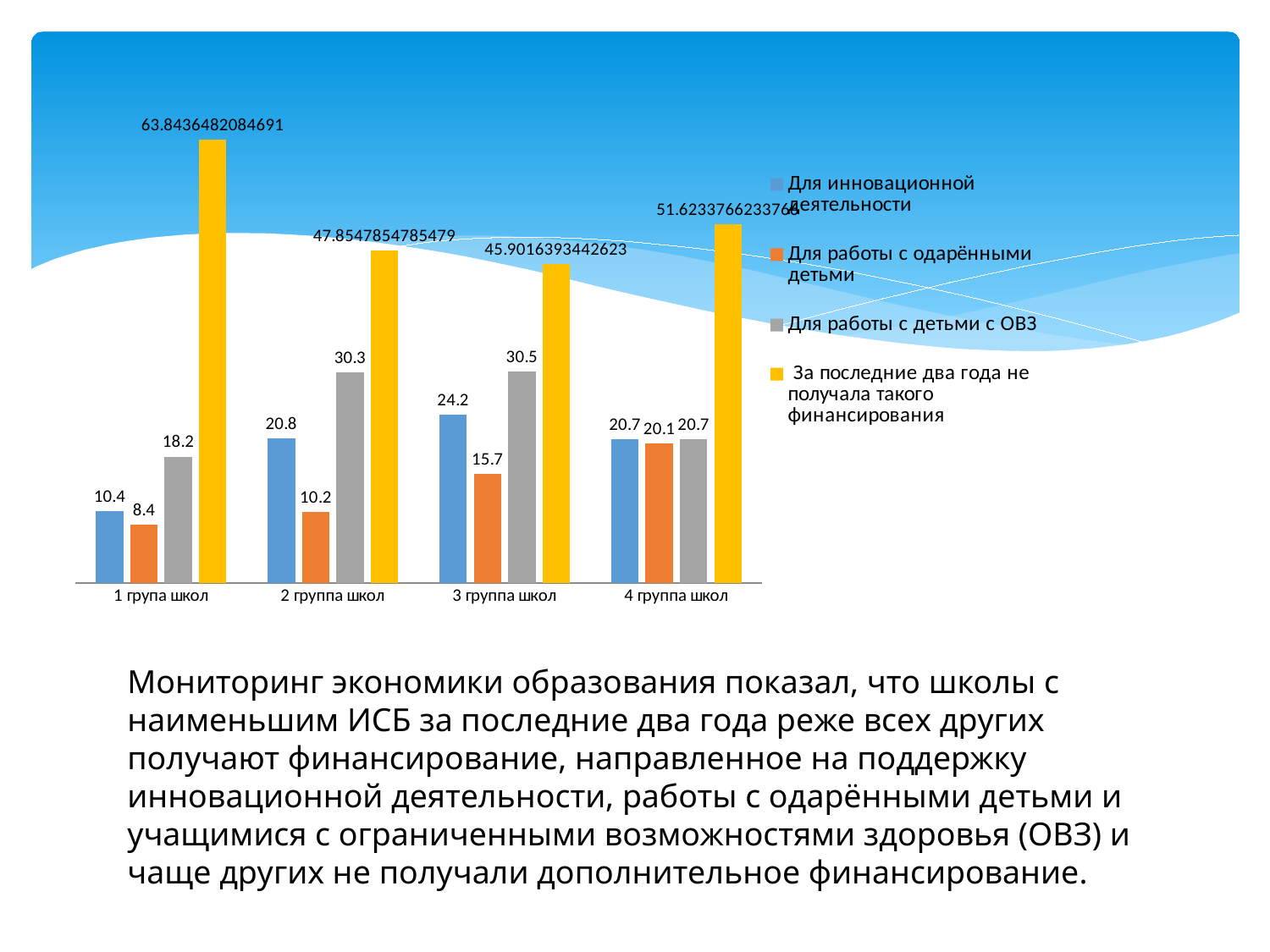
How many school groups (categories) are shown on the x axis? 4 What is the difference between the 'Для работы с детьми с ОВЗ' values for 3 группа школ and 1 група школ? 12.3 What kind of chart is shown on the slide? bar chart Which school group has the lowest value for 'Для работы с одарёнными детьми'? 1 група школ What is the value for 'Для инновационной деятельности' in 1 група школ? 10.4 Which series is shown in yellow in the legend? За последние два года не получала такого финансирования How many series does the legend list? 4 Which school group has the highest value for 'За последние два года не получала такого финансирования'? 1 група школ What is the value for 'Для работы с детьми с ОВЗ' in 2 группа школ? 30.3 What is the value for 'За последние два года не получала такого финансирования' in 1 група школ? 63.8436482084691 What is the value for 'Для работы с одарёнными детьми' in 3 группа школ? 15.7 Which is larger: the 'Для инновационной деятельности' value for 2 группа школ or for 3 группа школ? 3 группа школ